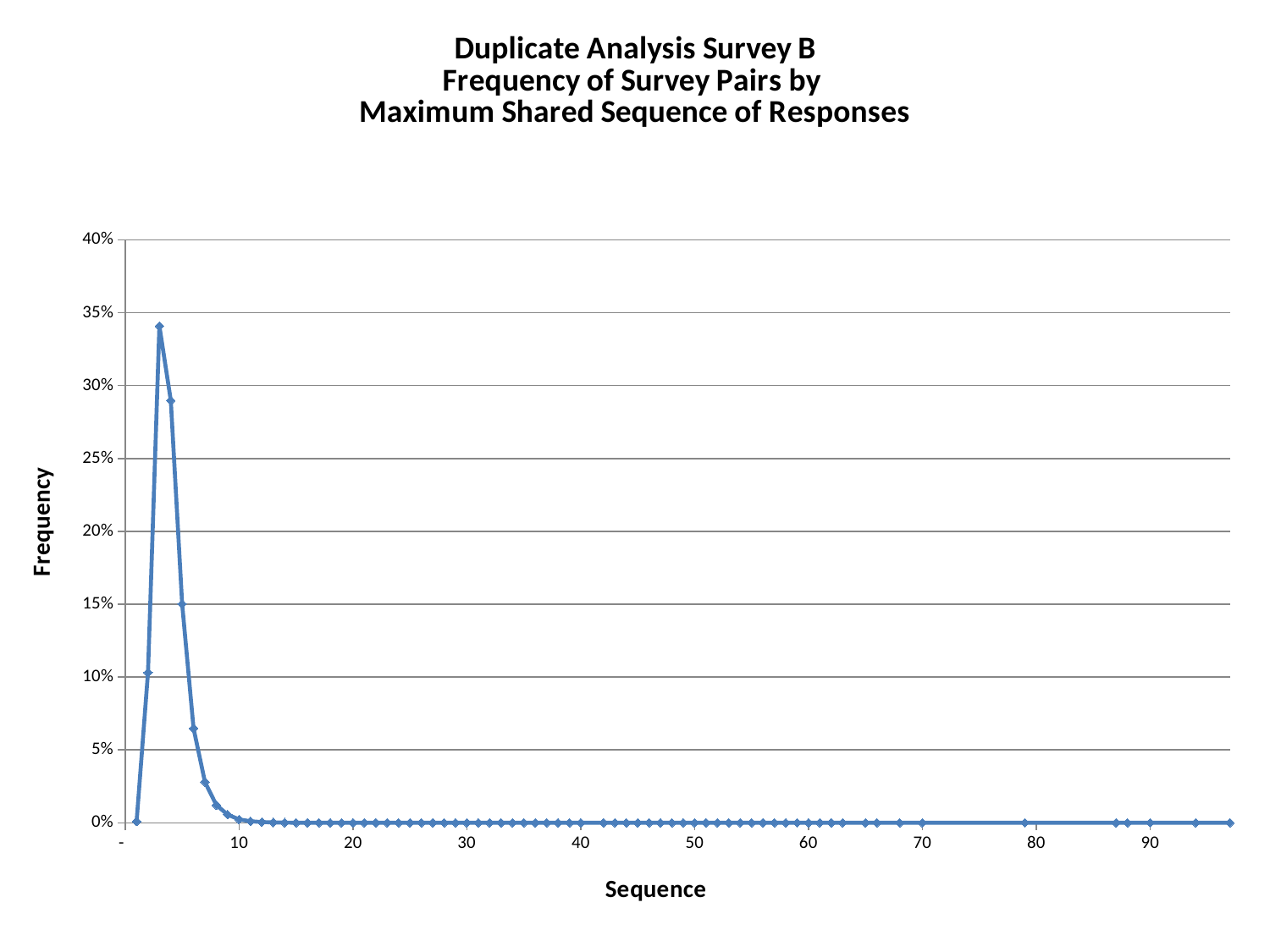
What is the title of the chart? Duplicate Analysis Survey B Frequency of Survey Pairs by Maximum Shared Sequence of Responses Is the peak frequency value on the chart greater or less than 35%? less Which is larger, the frequency at sequence 5 or the frequency at sequence 20? sequence 5 After the peak, do the frequency values rise or fall as the sequence increases? fall What is the label of the vertical axis? Frequency Is the frequency at sequence 5 greater or less than 10%? greater Is the frequency at sequence 10 greater or less than 5%? less What is the highest value shown on the vertical axis? 40% What kind of chart is shown on the slide? Line chart